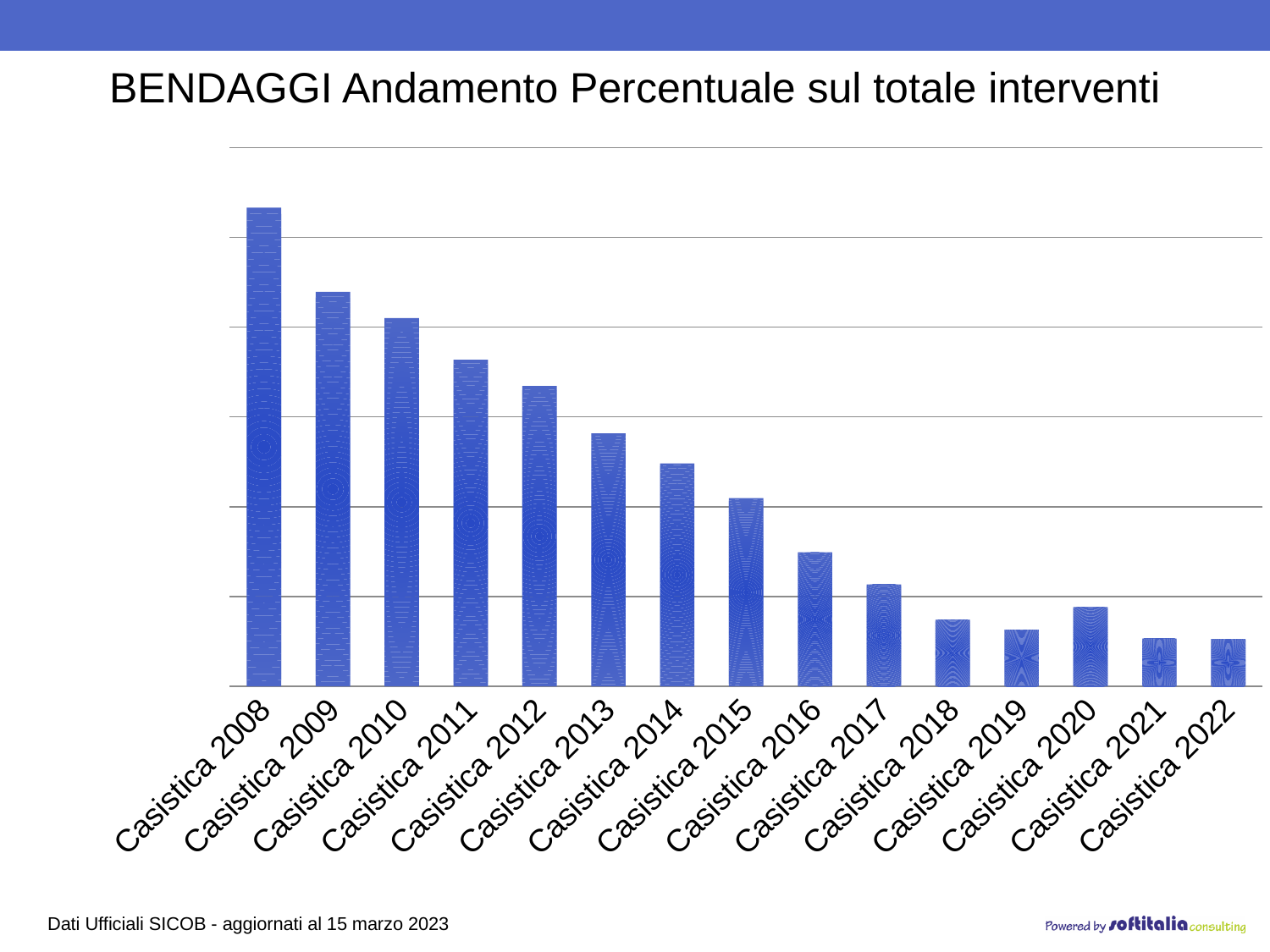
Which is larger, the value for Casistica 2019 or Casistica 2020? Casistica 2020 Which category has the highest value? Casistica 2008 What is the first category on the x axis? Casistica 2008 Which is larger, the value for Casistica 2020 or Casistica 2021? Casistica 2020 Which is larger, the value for Casistica 2008 or Casistica 2009? Casistica 2008 What is the title of the chart? BENDAGGI Andamento Percentuale sul totale interventi What kind of chart is shown on the slide? bar chart Do the values generally rise or fall from Casistica 2008 to Casistica 2022? fall How many categories (bars) are plotted in the chart? 15